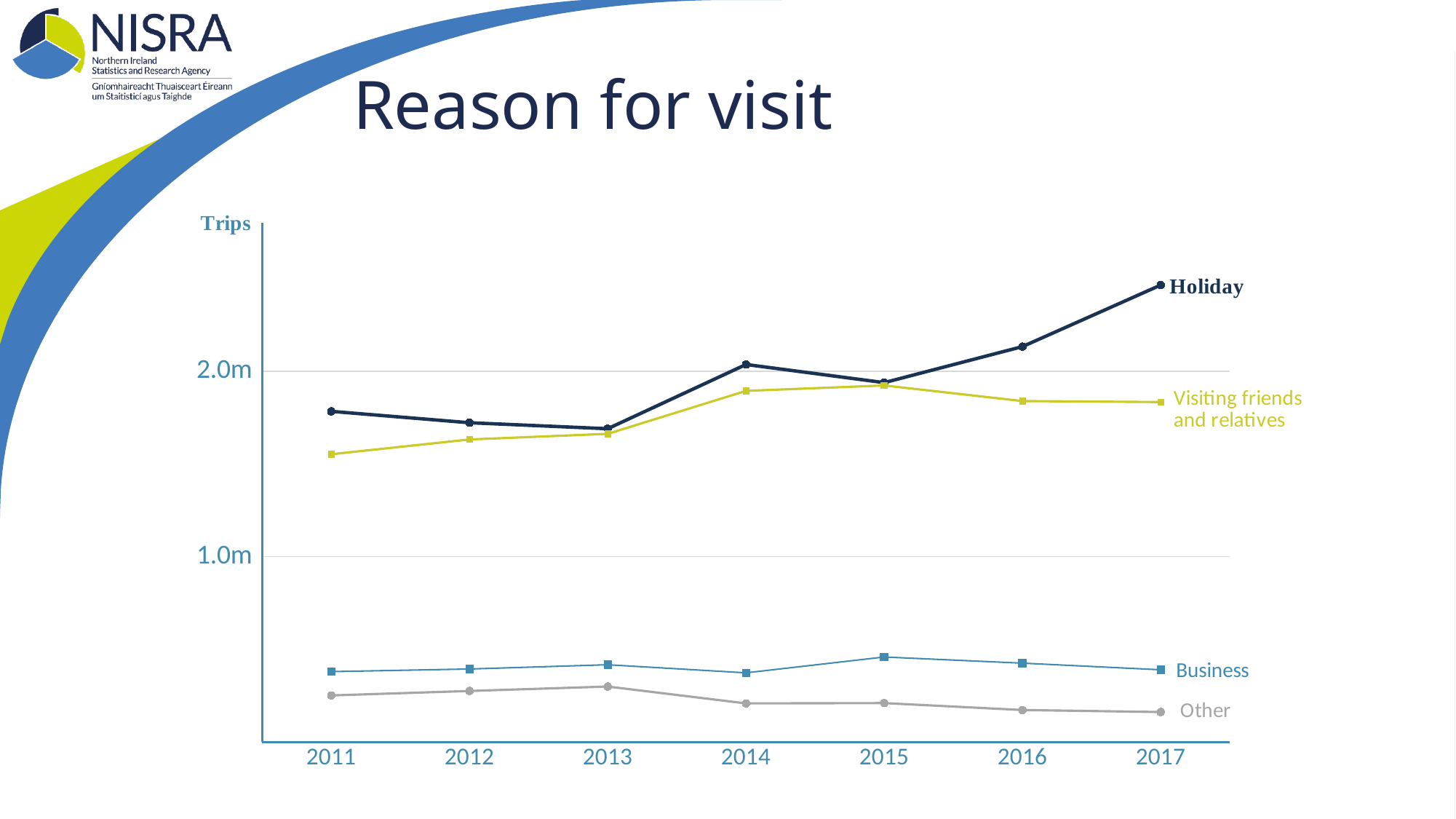
What kind of chart is shown on the slide? line chart Is the value for Holiday in 2011 greater or less than 2.0m? less Does the Holiday series rise or fall between 2015 and 2017? rise How many series are plotted on the chart? 4 Is the value for Holiday in 2017 greater or less than 2.0m? greater Is the value for Business in 2015 greater or less than 1.0m? less How many years are shown along the x axis? 7 In 2017, which is larger: Holiday or Visiting friends and relatives? Holiday Which series has the lowest value in 2017? Other Which series has the highest value in 2017? Holiday What is the title of the chart? Reason for visit